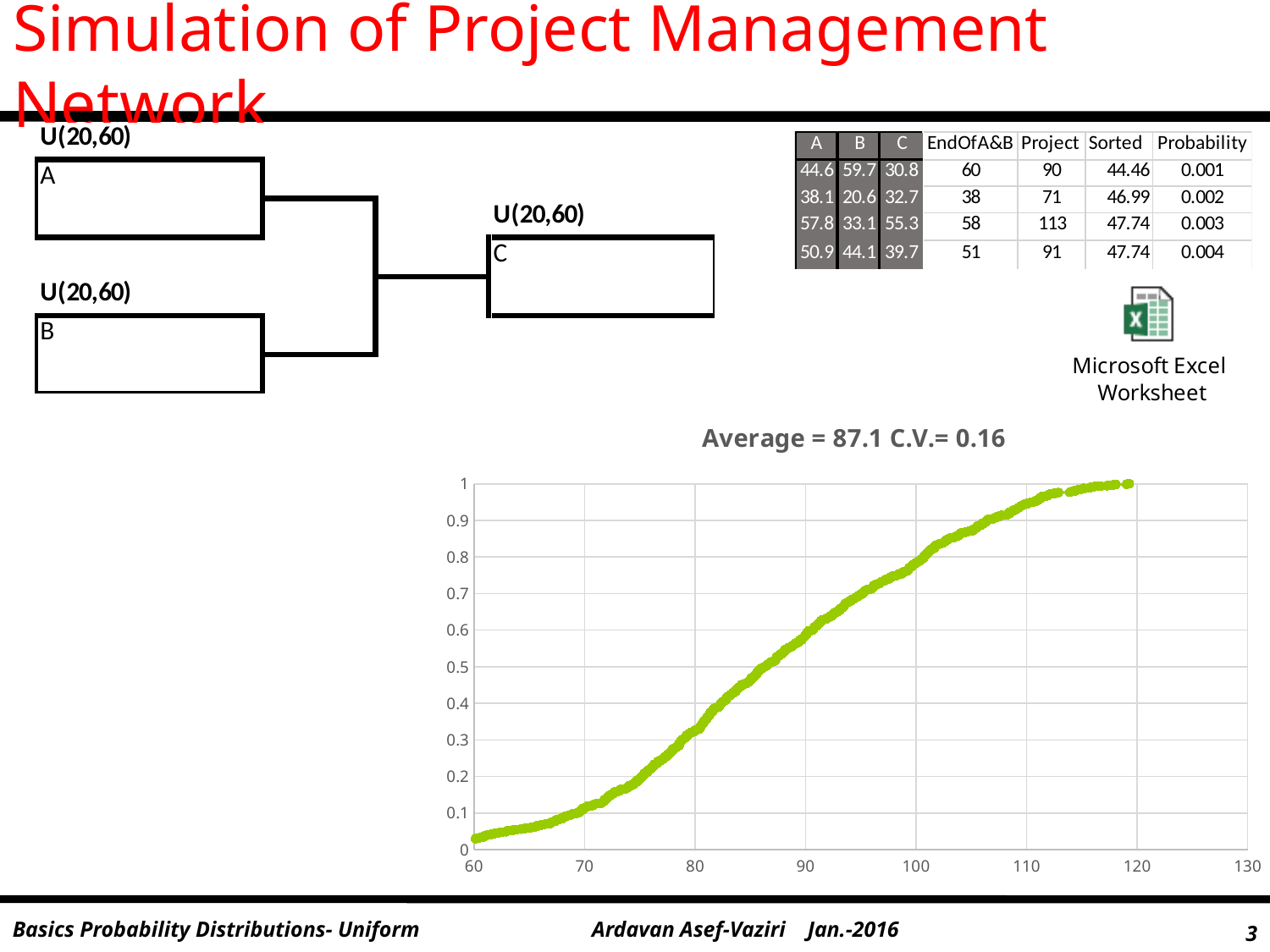
Is the plotted value at x = 80 greater or less than 0.5? less Is the plotted value at x = 90 greater or less than 0.4? greater Is the plotted value at x = 110 greater or less than 0.9? greater Which is larger, the plotted value at x = 100 or the plotted value at x = 80? x = 100 What is the title of the chart? Average = 87.1 C.V.= 0.16 Do the plotted values rise or fall as the x axis increases from 60 to 120? rise What is the highest value shown on the chart's y axis? 1 What kind of chart is shown on the slide? scatter chart